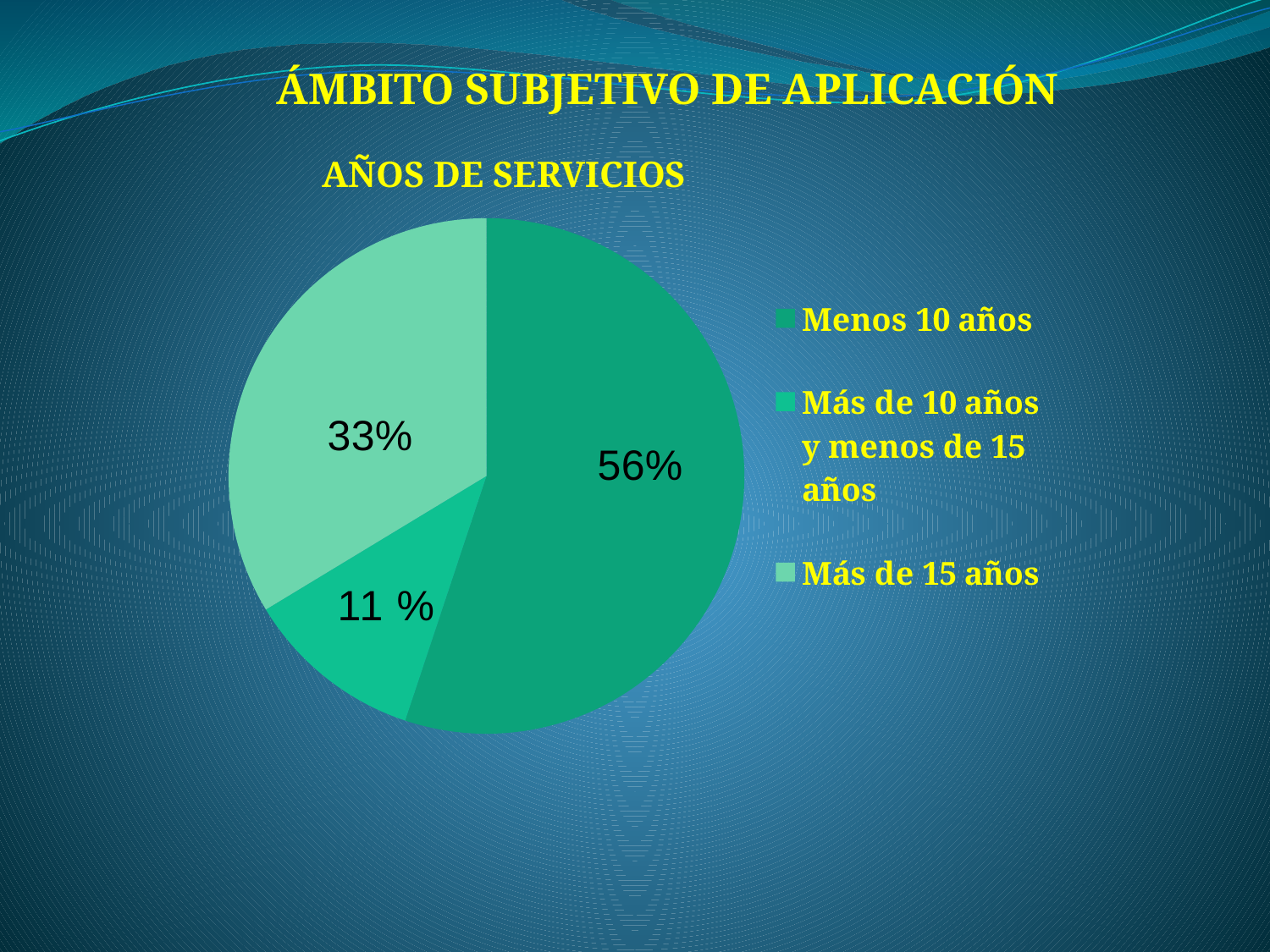
What percentage of the pie corresponds to "Más de 15 años"? 33% Which is larger, the share for "Más de 15 años" or the share for "Más de 10 años y menos de 15 años"? Más de 15 años What percentage of the pie corresponds to "Más de 10 años y menos de 15 años"? 11 % How many slices does the pie chart have? 3 Is the share for "Menos 10 años" greater or less than 50%? greater Which category has the smallest share of the pie? Más de 10 años y menos de 15 años How many entries does the legend list? 3 What is the difference in percentage points between "Menos 10 años" and "Más de 15 años"? 23 What percentage of the pie corresponds to "Menos 10 años"? 56% What kind of chart is shown on the slide? pie chart What is the chart's title? AÑOS DE SERVICIOS Which category has the largest share of the pie? Menos 10 años